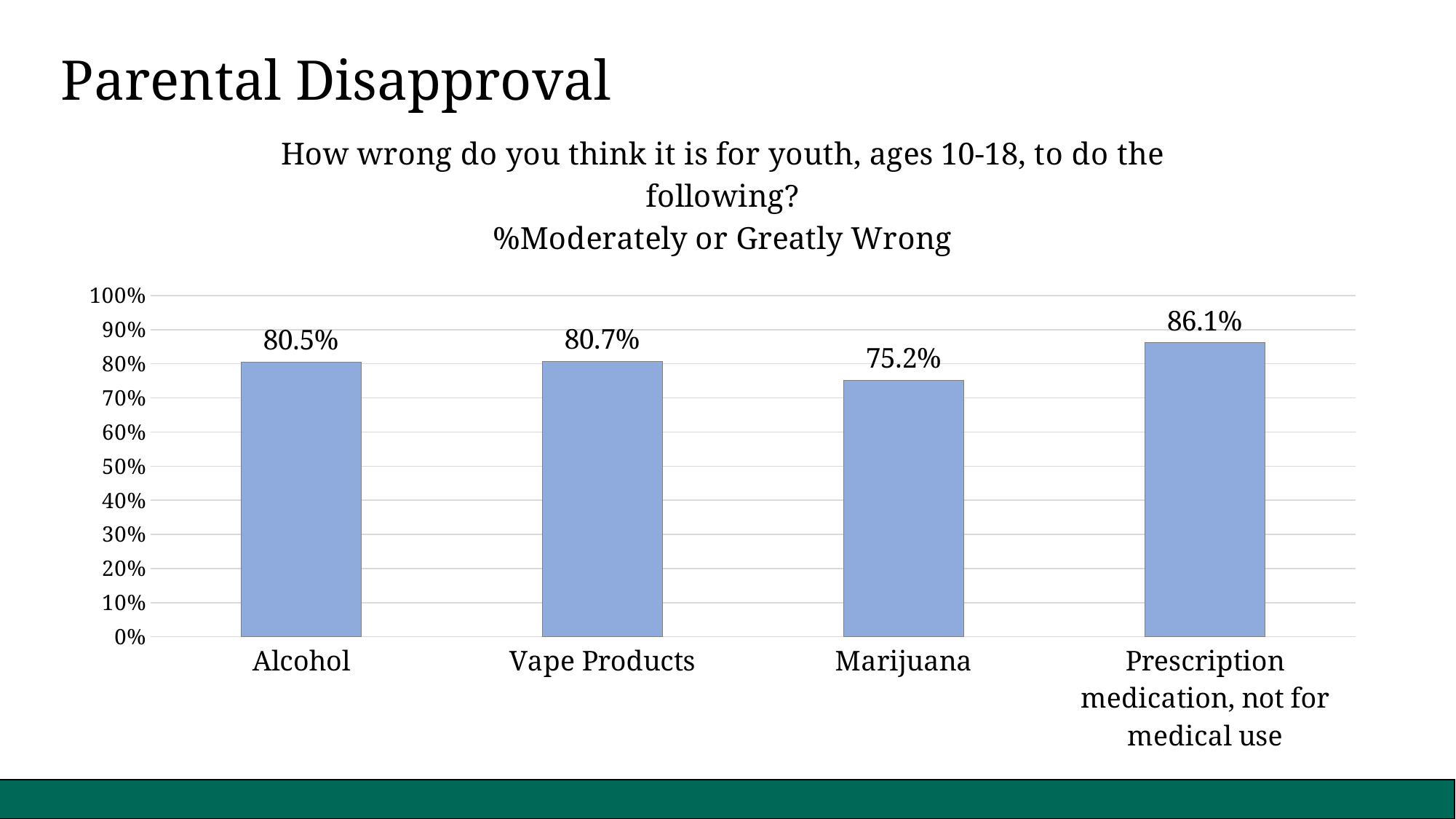
What is the difference between the values for Vape Products and Alcohol? 0.2% Which category has the lowest percentage? Marijuana What is the value shown for Marijuana? 75.2% What is the value shown for Vape Products? 80.7% What is the maximum value shown on the vertical axis? 100% What is the value shown for prescription medication, not for medical use? 86.1% Which is larger, the value for Alcohol or the value for Marijuana? Alcohol How many categories are shown on the chart? 4 What is the difference between the values for prescription medication, not for medical use and Marijuana? 10.9% Which category has the highest percentage? Prescription medication, not for medical use What kind of chart is shown on the slide? Bar chart What percentage of parents think it is moderately or greatly wrong for youth to use alcohol? 80.5%